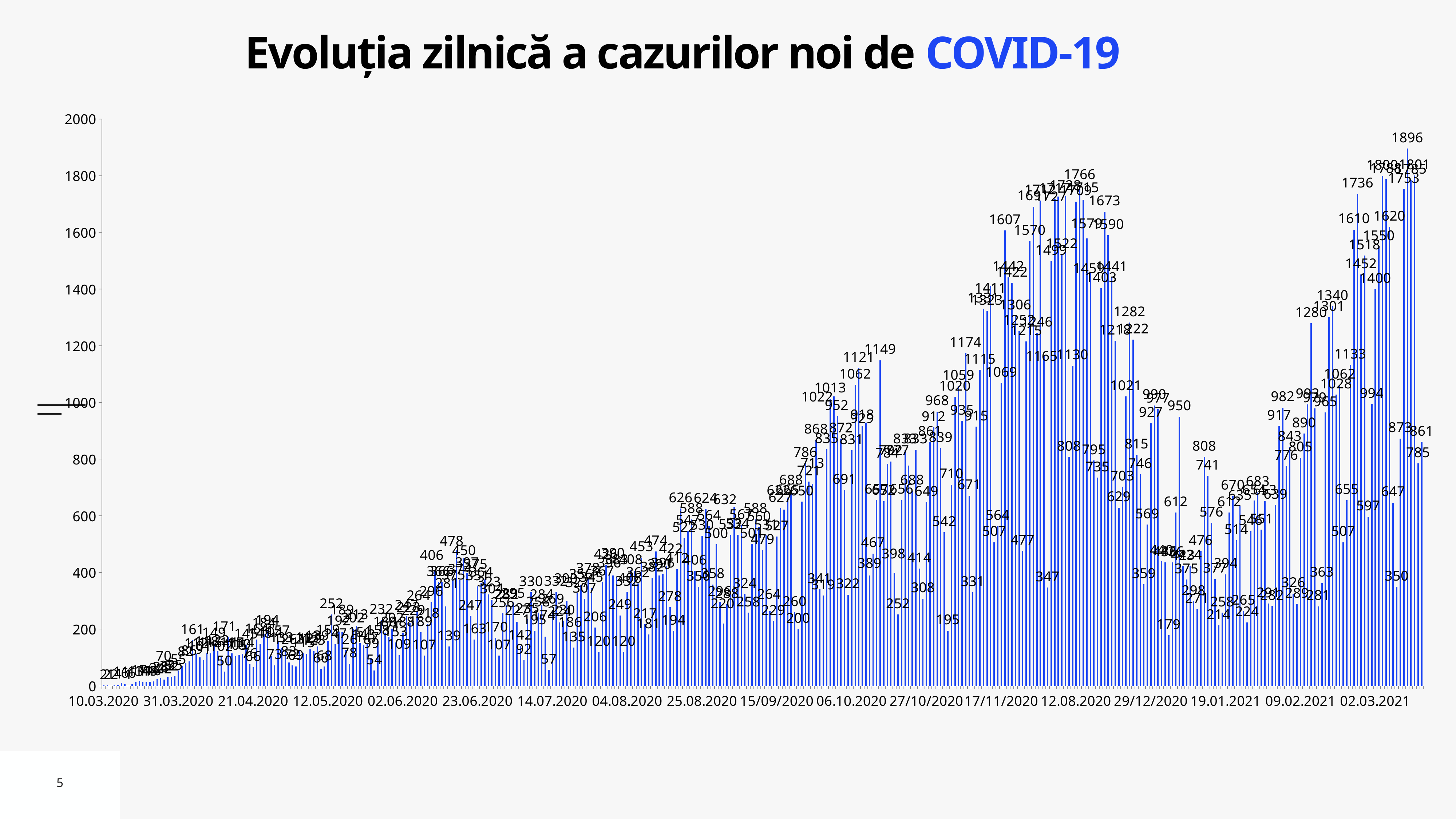
Is the value at 12.05.2020 greater or less than 400? less How many date labels are shown along the horizontal axis? 18 Which is larger, the peak labeled 1766 near 12.08.2020 or the peak labeled 1896 near 02.03.2021? 1896 What is the difference between the peak labeled 1896 and the peak labeled 1766? 130 What is the title of the chart? Evoluția zilnică a cazurilor noi de COVID-19 What is the maximum value shown on the vertical axis? 2000 Is the value at 10.03.2020 greater or less than 200? less What is the highest value labeled on the chart? 1896 Is the value at 14.07.2020 greater or less than 600? less Overall, do the daily values rise or fall from 10.03.2020 to 02.03.2021? rise What kind of chart is shown on the slide? bar chart